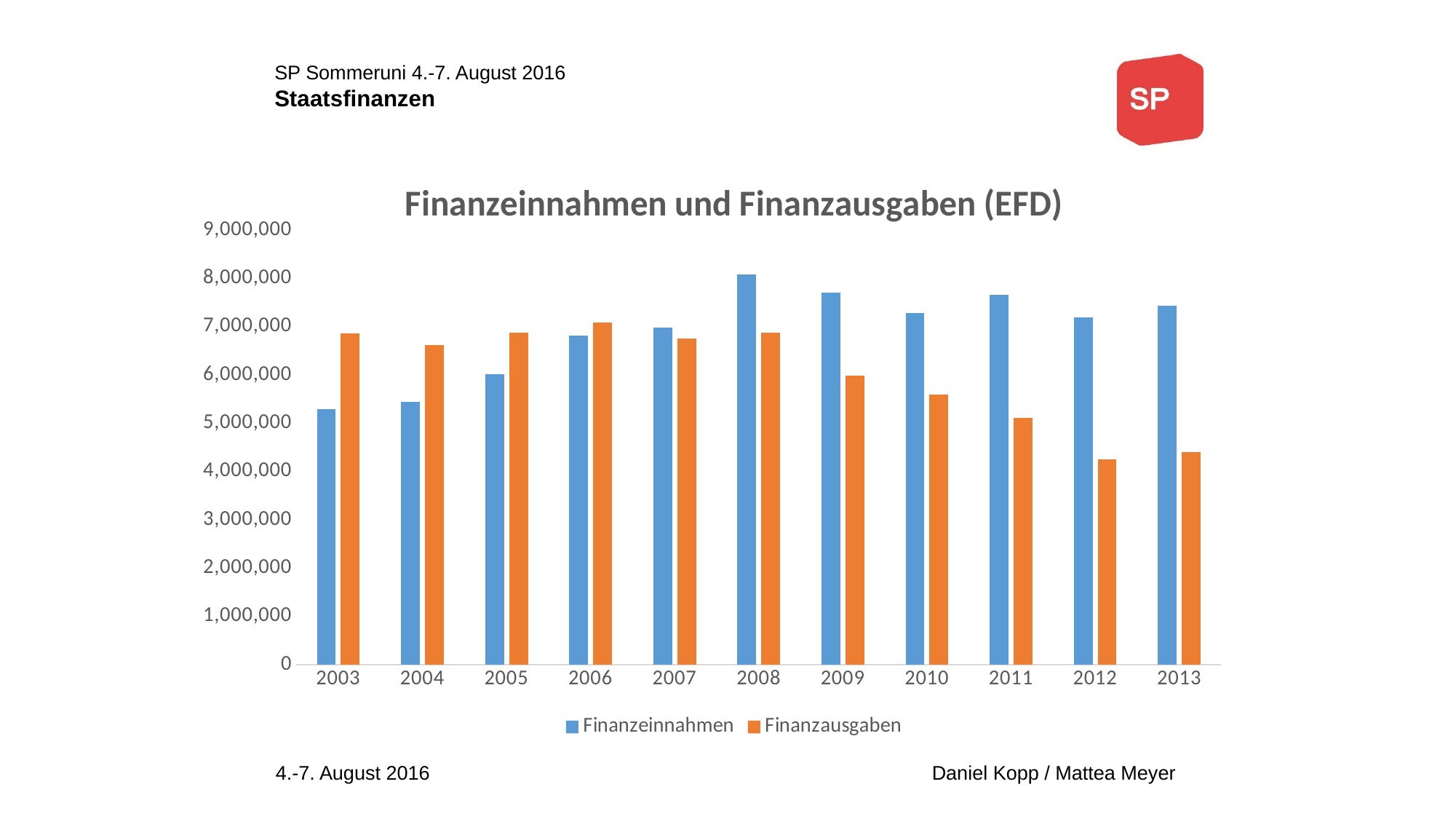
Is the value for Finanzeinnahmen in 2008 greater or less than 7,000,000? greater Is the value for Finanzausgaben in 2012 greater or less than 5,000,000? less In 2003, which is larger: Finanzeinnahmen or Finanzausgaben? Finanzausgaben Do the Finanzausgaben rise or fall from 2008 to 2012? fall How many series does the legend list? 2 What is the title of the chart? Finanzeinnahmen und Finanzausgaben (EFD) In which year are the Finanzeinnahmen highest? 2008 How many years are shown on the x axis? 11 What kind of chart is shown on the slide? bar chart Is the value for Finanzeinnahmen in 2003 greater or less than 6,000,000? less In 2013, which is larger: Finanzeinnahmen or Finanzausgaben? Finanzeinnahmen